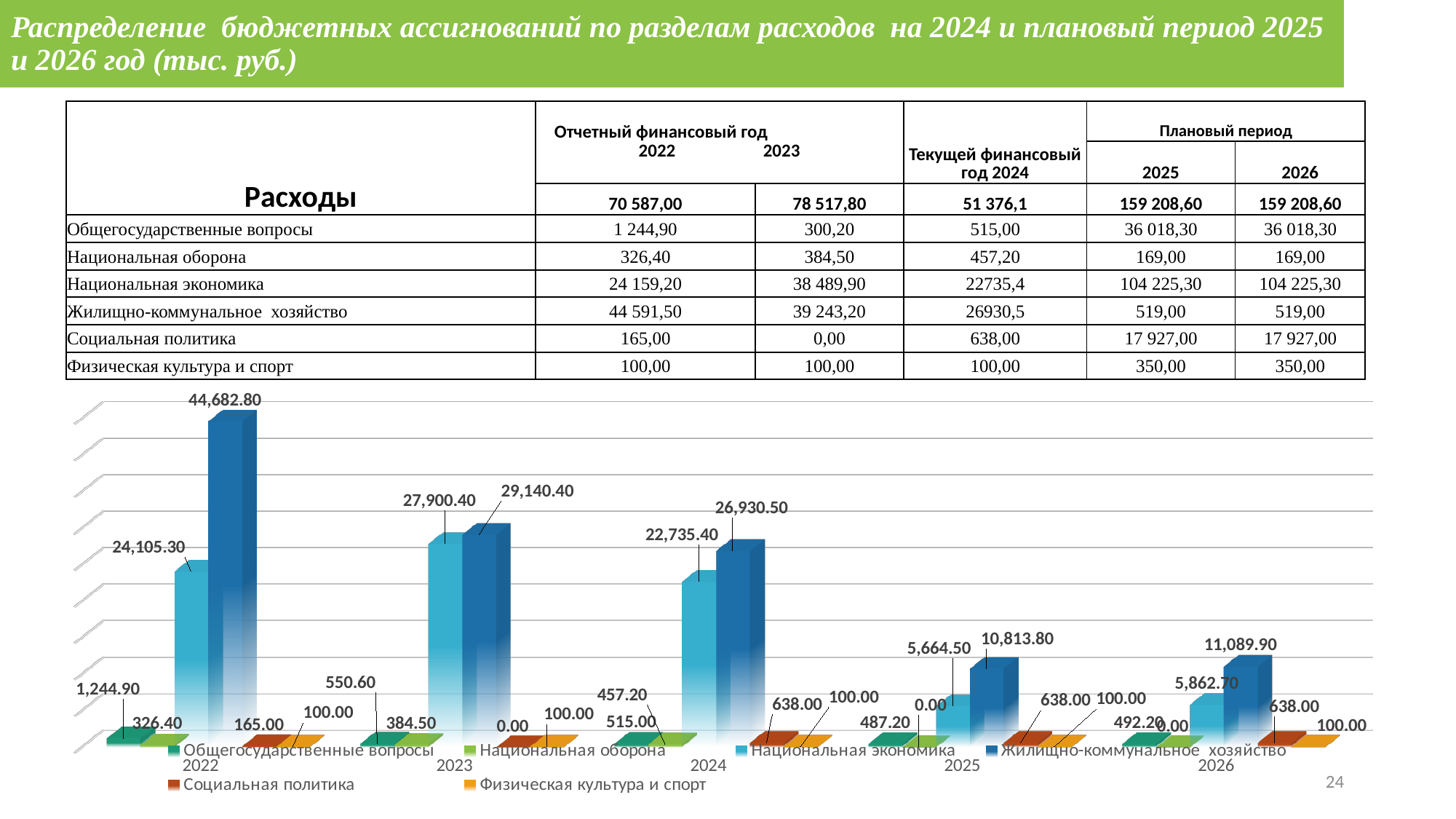
In the bar chart, what is the value for Жилищно-коммунальное хозяйство in 2026? 11,089.90 In the bar chart, what is the value for Социальная политика in 2023? 0.00 In the bar chart, which year has the lowest value for Национальная экономика? 2025 In the bar chart, which is larger in 2025: Национальная экономика or Жилищно-коммунальное хозяйство? Жилищно-коммунальное хозяйство In the bar chart, what is the value for Жилищно-коммунальное хозяйство in 2022? 44,682.80 How many series does the legend of the bar chart list? 6 In the bar chart, which year has the highest value for Жилищно-коммунальное хозяйство? 2022 In the bar chart, what is the value for Национальная экономика in 2023? 27,900.40 What kind of chart is shown below the table on the slide? bar chart In the bar chart, what is the value for Национальная оборона in 2024? 457.20 How many year categories are shown along the x axis of the bar chart? 5 In the bar chart, what is the difference between Жилищно-коммунальное хозяйство and Национальная экономика in 2022? 20,577.50